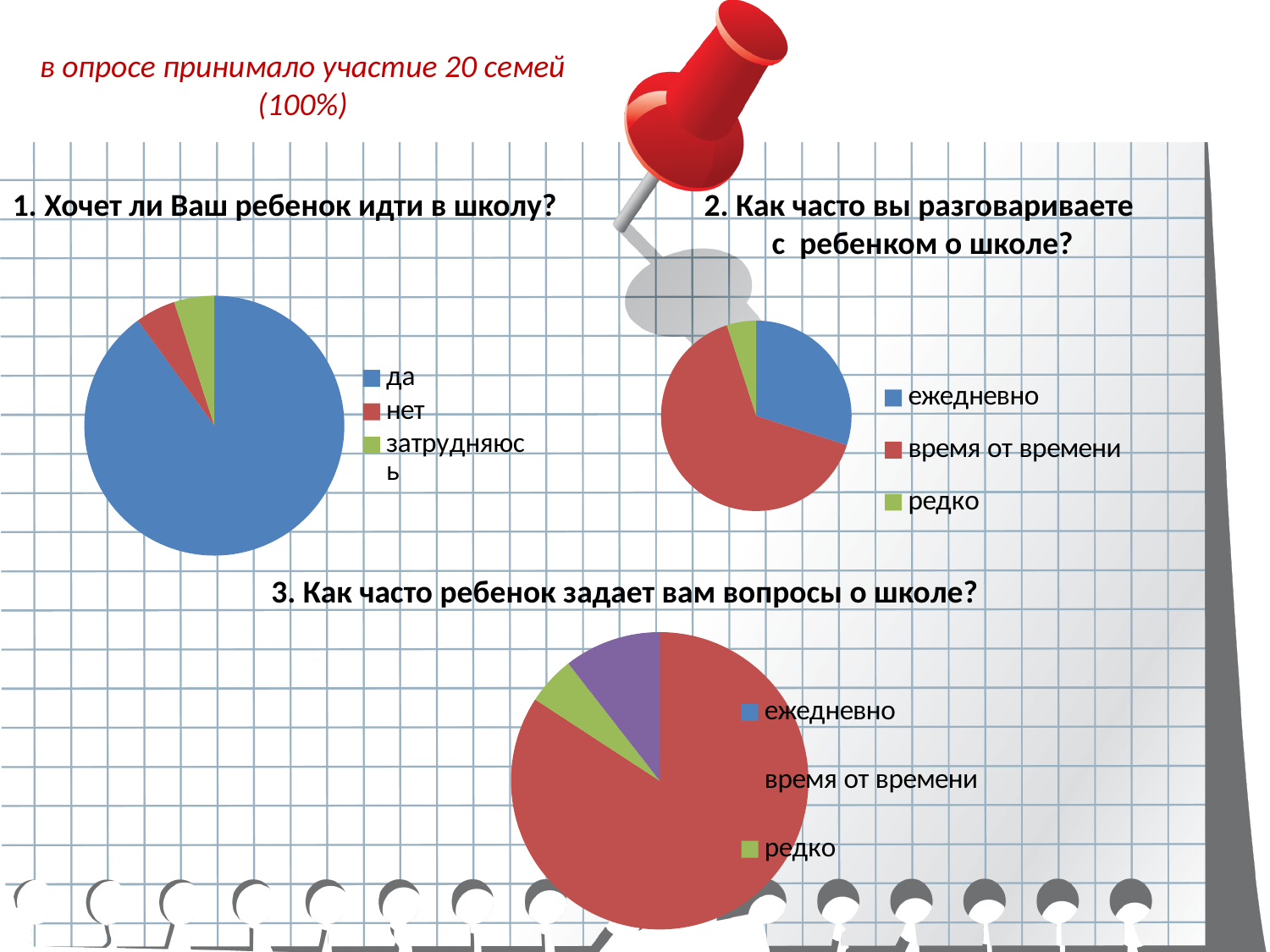
How many entries does the legend of the chart for question 3 ('Как часто ребенок задает вам вопросы о школе?') list? 3 How many charts are shown on the slide? 3 In the chart for question 1 ('Хочет ли Ваш ребенок идти в школу?'), which answer has the largest share? да What kind of chart is used for question 3, 'Как часто ребенок задает вам вопросы о школе?' Pie chart In the chart for question 1 ('Хочет ли Ваш ребенок идти в школу?'), which is larger: the share for 'да' or the share for 'нет'? да In the chart for question 2 ('Как часто вы разговариваете с ребенком о школе?'), which answer has the largest share? время от времени What colour is the 'да' slice in the chart for question 1 ('Хочет ли Ваш ребенок идти в школу?')? Blue In the chart for question 2 ('Как часто вы разговариваете с ребенком о школе?'), which is larger: the share for 'ежедневно' or the share for 'время от времени'? время от времени How many slices does the pie chart for question 2 ('Как часто вы разговариваете с ребенком о школе?') have? 3 How many entries does the legend of the chart for question 1 ('Хочет ли Ваш ребенок идти в школу?') list? 3 What kind of chart is used for question 1, 'Хочет ли Ваш ребенок идти в школу?' Pie chart In the chart for question 2 ('Как часто вы разговариваете с ребенком о школе?'), which answer has the smallest share? редко